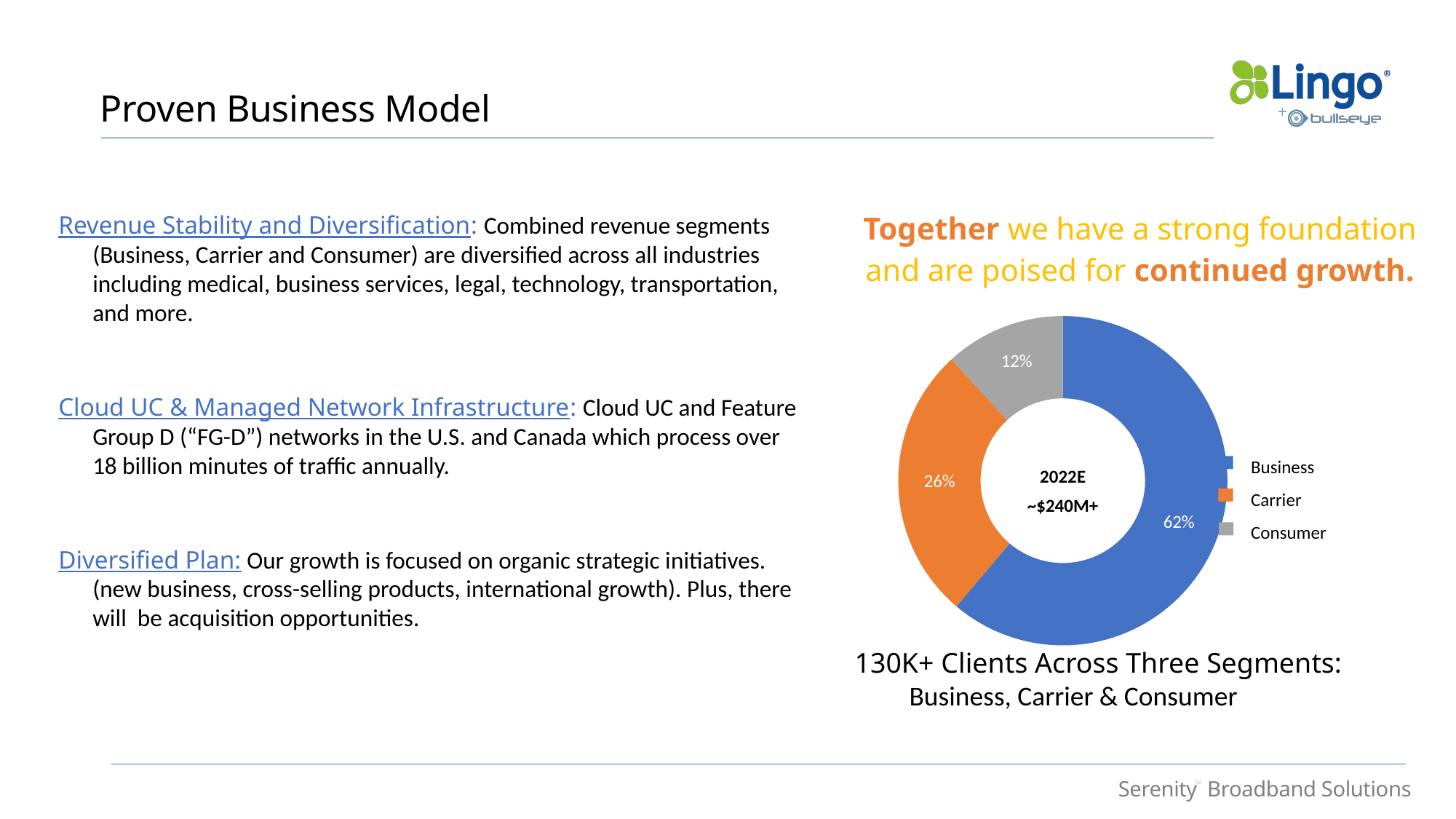
What kind of chart is shown on the slide? Donut (pie) chart What share of the donut chart does the Consumer segment represent? 12% Which segment has a larger share, Carrier or Consumer? Carrier What colour represents the Carrier segment in the donut chart? Orange How many segments are shown in the donut chart? 3 What text is shown in the center of the donut chart? 2022E ~$240M+ What share of the donut chart does the Carrier segment represent? 26% What share of the donut chart does the Business segment represent? 62% Which segment has the smallest share in the donut chart? Consumer What is the difference in percentage points between the Carrier and Consumer shares? 14 Which segment has the largest share in the donut chart? Business What is the difference in percentage points between the Business and Carrier shares? 36